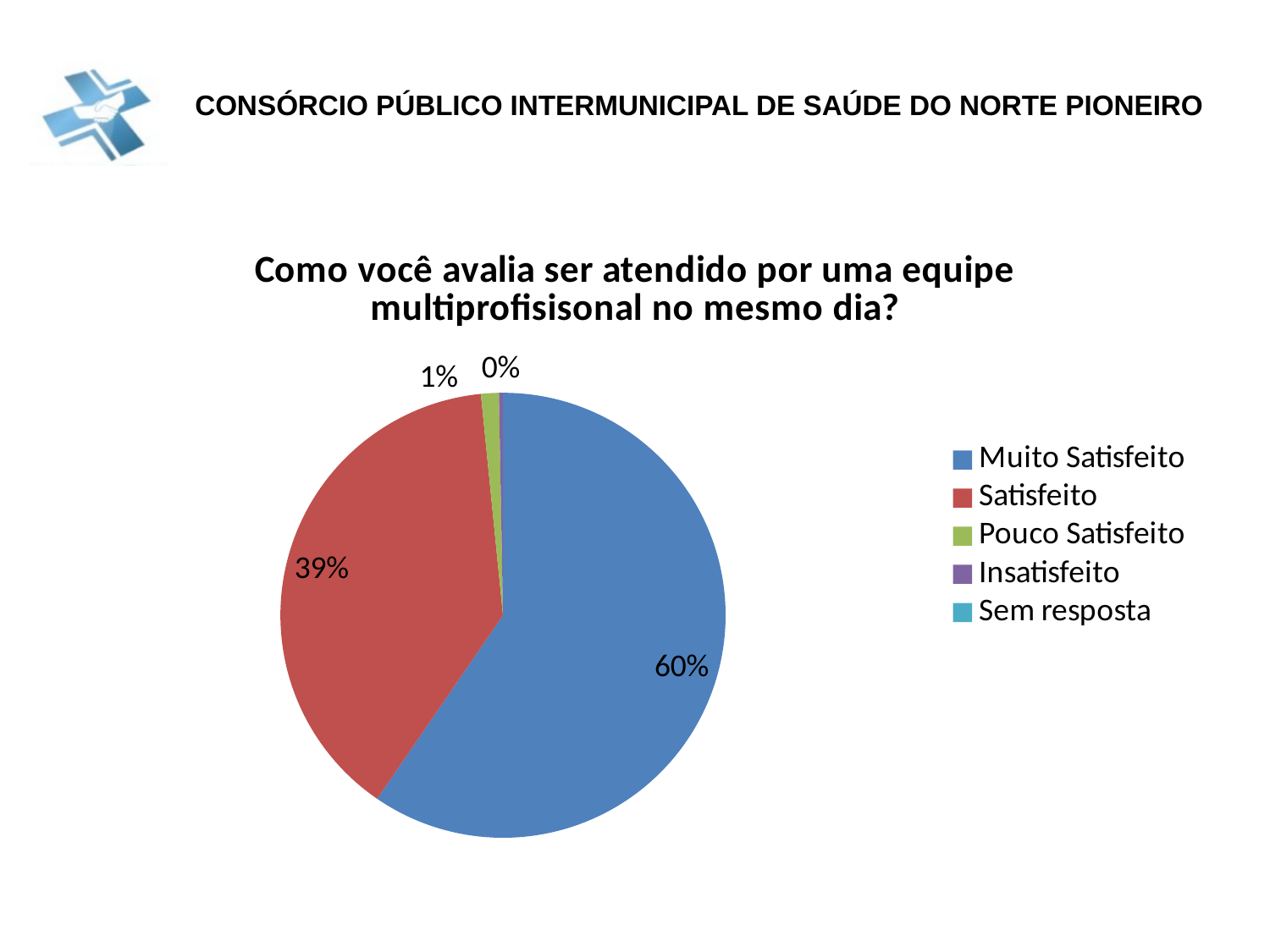
What share of the pie does Muito Satisfeito have? 60% What kind of chart is shown on the slide? pie chart How many entries does the legend list? 5 What is the title of the chart? Como você avalia ser atendido por uma equipe multiprofisisonal no mesmo dia? What share of the pie does Pouco Satisfeito have? 1% Which category has the largest slice of the pie? Muito Satisfeito What share of the pie does Satisfeito have? 39% Is the share for Muito Satisfeito greater or less than 50%? greater What is the difference in percentage points between the Muito Satisfeito slice and the Satisfeito slice? 21 What colour is the Muito Satisfeito slice? blue Which is larger, the slice for Satisfeito or the slice for Pouco Satisfeito? Satisfeito